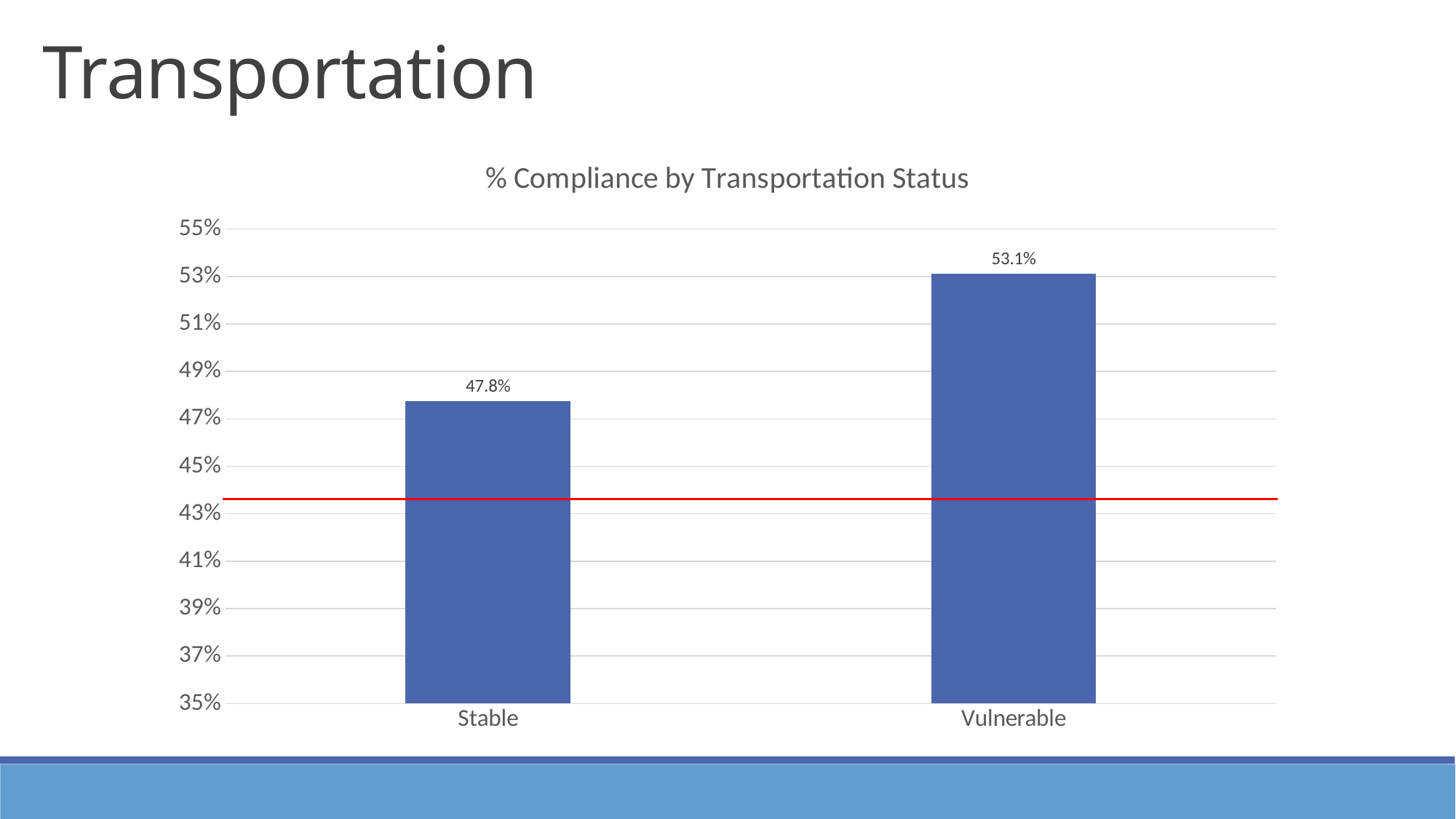
Which transportation status has the highest % compliance? Vulnerable What is the difference in % compliance between Vulnerable and Stable? 5.3% Which has a larger % compliance, Stable or Vulnerable? Vulnerable Is the value for Stable greater or less than 45%? greater What is the % compliance for the Stable transportation status? 47.8% Which transportation status has the lowest % compliance? Stable What kind of chart is shown on the slide? Bar chart What is the % compliance for the Vulnerable transportation status? 53.1% What colour is the horizontal reference line drawn across the chart? Red Is the value for Vulnerable greater or less than 55%? less How many transportation status categories are shown in the chart? 2 What is the title of the chart? % Compliance by Transportation Status